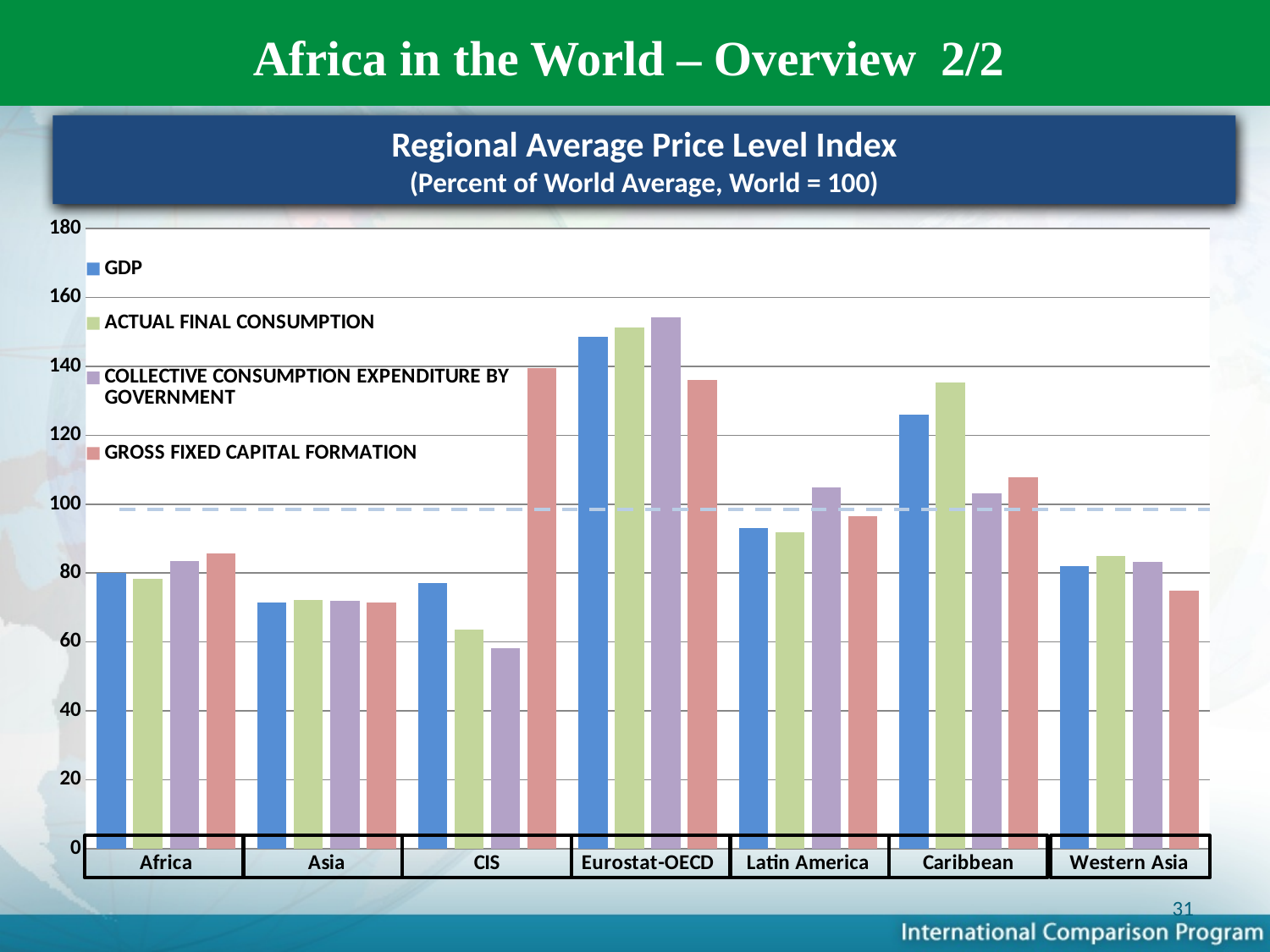
Which is larger, the GDP value for Caribbean or the GDP value for Latin America? Caribbean For CIS, which is larger: Actual Final Consumption or Gross Fixed Capital Formation? Gross Fixed Capital Formation Which region has the highest GDP price level index? Eurostat-OECD Which region has the lowest value for Collective Consumption Expenditure by Government? CIS Is the Actual Final Consumption value for Caribbean greater or less than 120? greater Is the Gross Fixed Capital Formation value for CIS greater or less than 120? greater How many series does the legend list? 4 What kind of chart is shown on the slide? Bar chart Which region has the lowest GDP price level index? Asia Is the GDP value for Africa greater or less than 100? less How many regions are shown on the x axis? 7 What is the title of the chart? Regional Average Price Level Index (Percent of World Average, World = 100)